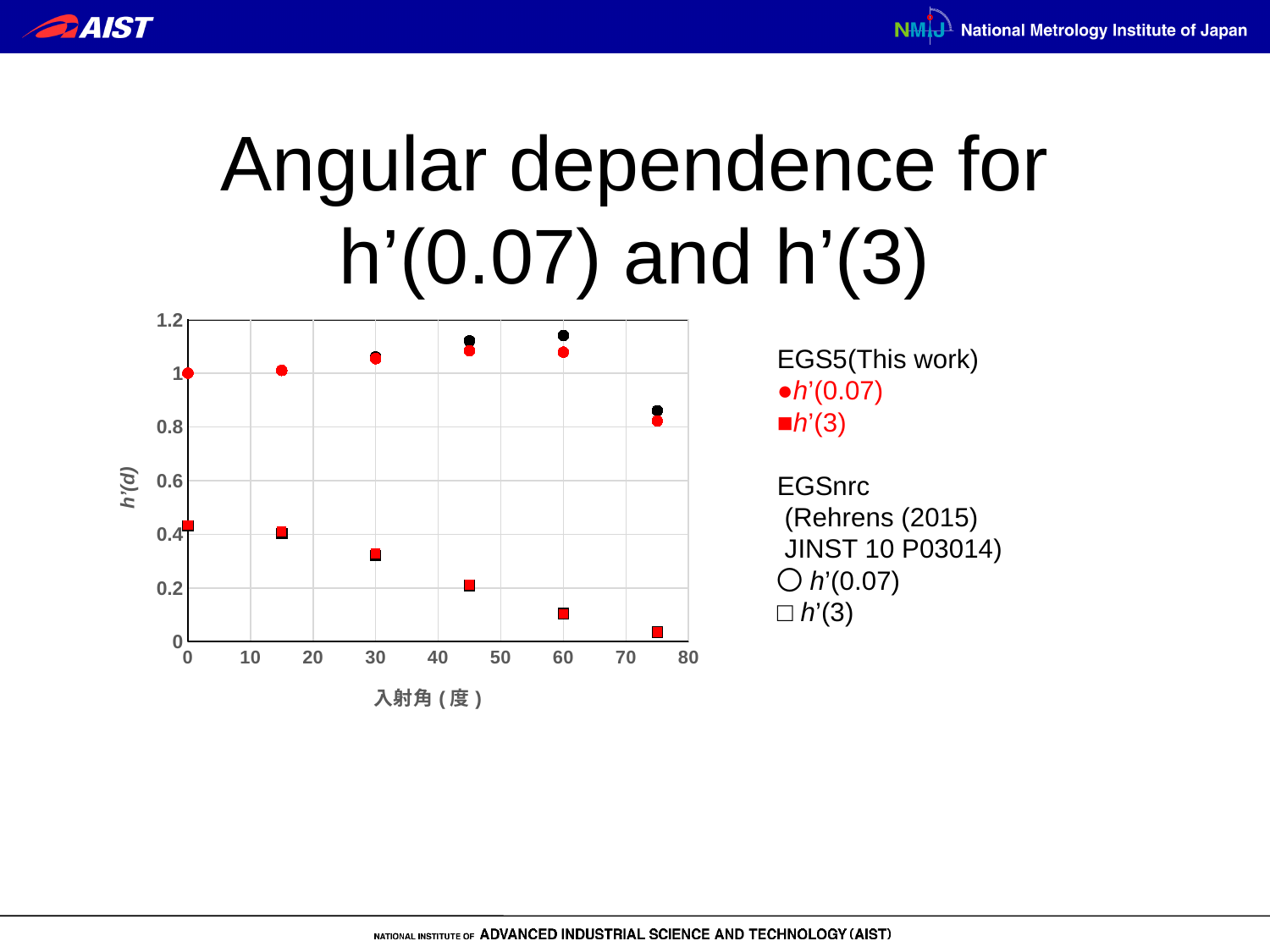
Is the EGS5 h'(3) value at 45 degrees greater or less than 0.4? less At which incident angle is the EGS5 h'(3) value highest? 0 What kind of chart is shown on the slide? scatter chart At which incident angle is the EGS5 h'(0.07) value lowest? 75 At 30 degrees, which is larger: the EGS5 h'(0.07) value or the EGS5 h'(3) value? h'(0.07) How many data points are plotted for the EGS5 h'(3) series? 6 At which incident angle is the EGS5 h'(3) value lowest? 75 What is the label on the y axis of the chart? h'(d) How many series does the legend list? 4 Is the EGS5 h'(0.07) value at 75 degrees greater or less than 1? less Is the EGS5 h'(0.07) value at 30 degrees greater or less than 1? greater Do the h'(3) values rise or fall as the incident angle increases along the x axis? fall